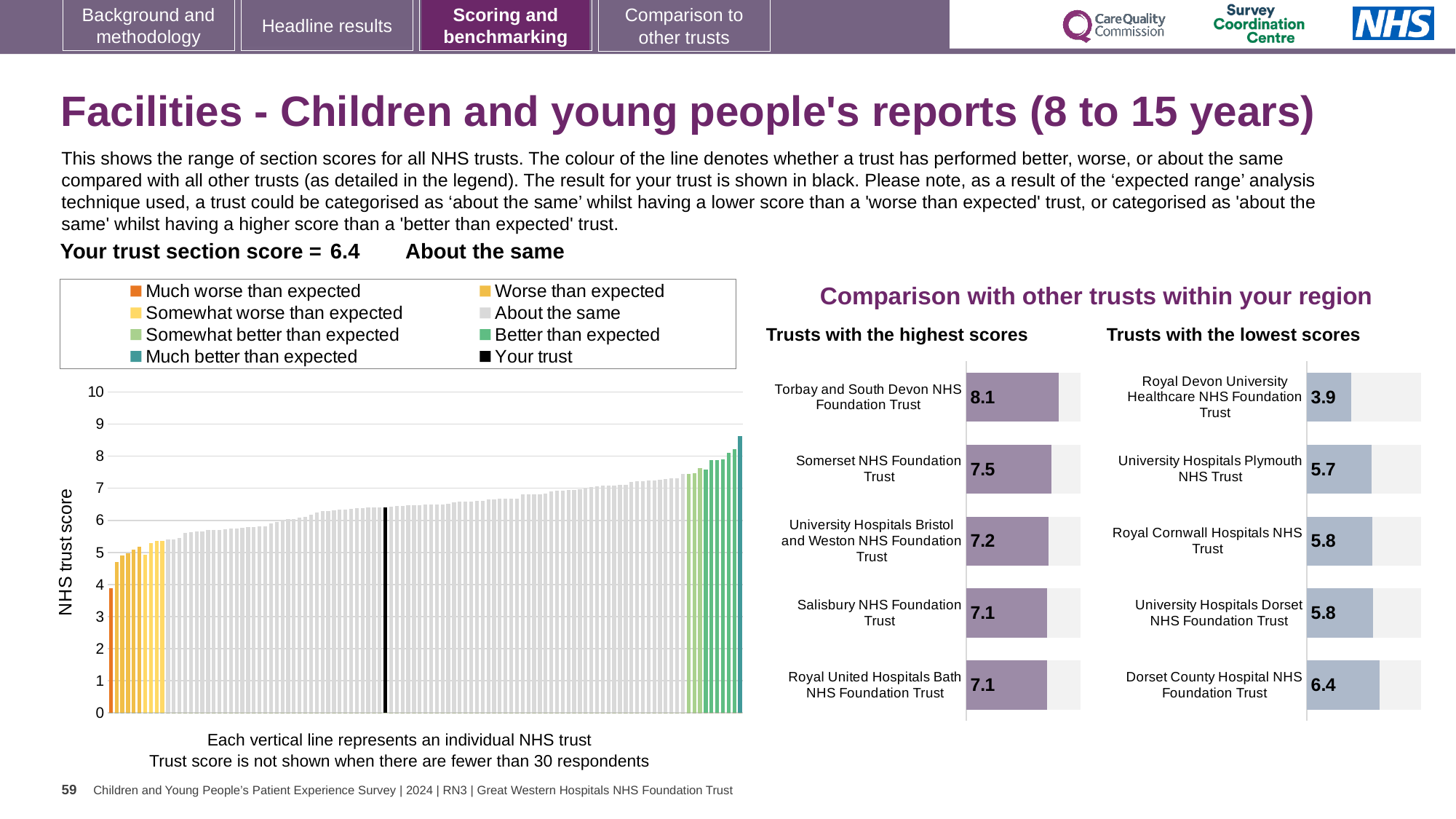
In the 'Trusts with the lowest scores' chart, which trust has the lowest score? Royal Devon University Healthcare NHS Foundation Trust In the 'Trusts with the lowest scores' chart, what is the score for Royal Devon University Healthcare NHS Foundation Trust? 3.9 In the 'Trusts with the highest scores' chart, which has the higher score: Somerset NHS Foundation Trust or University Hospitals Bristol and Weston NHS Foundation Trust? Somerset NHS Foundation Trust In the 'Trusts with the lowest scores' chart, what is the difference between the scores of Dorset County Hospital NHS Foundation Trust and Royal Devon University Healthcare NHS Foundation Trust? 2.5 In the 'Trusts with the highest scores' chart, which trust has the highest score? Torbay and South Devon NHS Foundation Trust In the main 'NHS trust score' chart on the left, is the value of the black 'Your trust' bar greater or less than 6? greater How many trusts are listed in the 'Trusts with the lowest scores' chart? 5 In the main 'NHS trust score' chart on the left, do the bars rise or fall from left to right? Rise In the 'Trusts with the highest scores' chart, what is the score for Torbay and South Devon NHS Foundation Trust? 8.1 What kind of chart is the main 'NHS trust score' chart on the left of the slide? Bar chart In the 'Trusts with the highest scores' chart, what is the difference between the scores of Torbay and South Devon NHS Foundation Trust and Somerset NHS Foundation Trust? 0.6 How many entries does the legend of the main 'NHS trust score' chart on the left list? 8